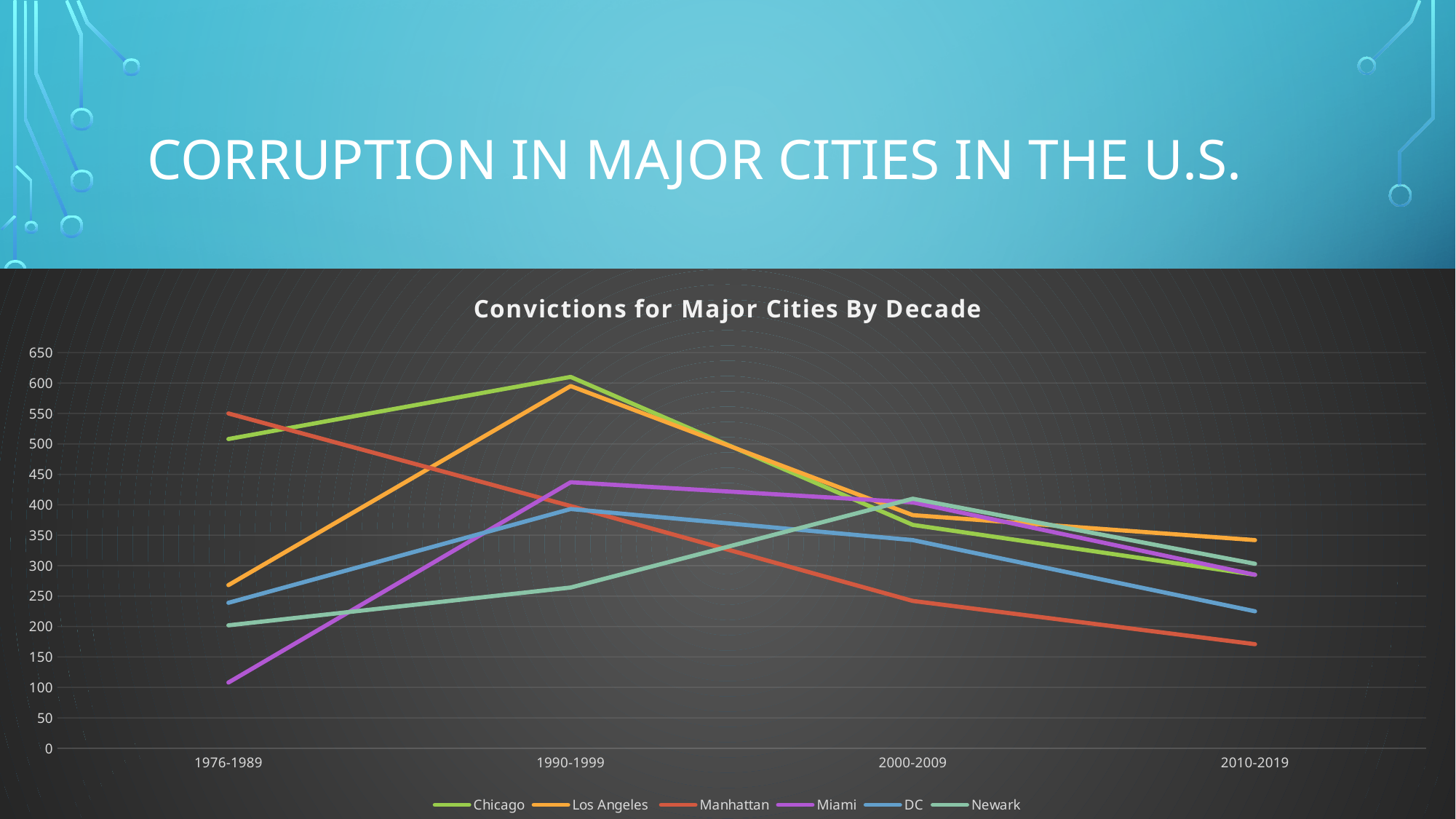
Which city has the highest number of convictions in 1976-1989? Manhattan How many series does the legend list? 6 Is the value for Miami in 1976-1989 greater or less than 150? less What is the title of the chart? Convictions for Major Cities By Decade Which is larger in 1976-1989, the value for Chicago or the value for Los Angeles? Chicago Is the value for Chicago in 1990-1999 greater or less than 550? greater Which city has the lowest number of convictions in 2010-2019? Manhattan What kind of chart is shown on the slide? line chart How many decade categories are shown on the x axis? 4 Is the value for Manhattan in 2010-2019 greater or less than 200? less Do Manhattan's convictions rise or fall across the decades from 1976-1989 to 2010-2019? fall Which city has the lowest number of convictions in 1976-1989? Miami